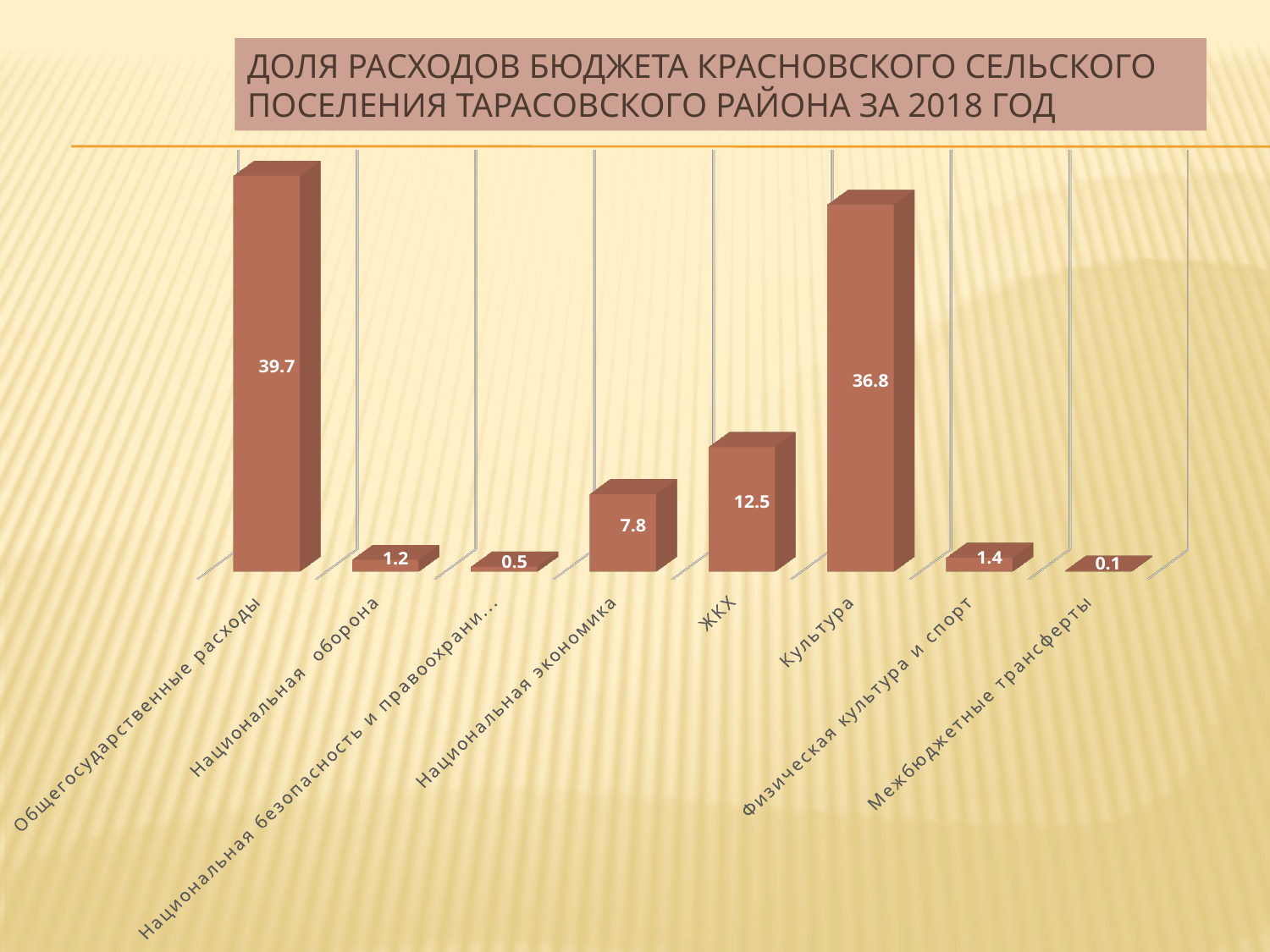
What is the difference between the values for Общегосударственные расходы and Культура? 2.9 What is the difference between the values for Физическая культура и спорт and Национальная оборона? 0.2 How many categories are shown in the chart? 8 Which category has the lowest value? Межбюджетные трансферты What is the value for Культура? 36.8 What is the value for Национальная экономика? 7.8 Which category has the highest value? Общегосударственные расходы Which is larger, the value for ЖКХ or the value for Национальная экономика? ЖКХ What kind of chart is shown on the slide? Bar chart What is the value for Общегосударственные расходы? 39.7 What is the value for Межбюджетные трансферты? 0.1 What is the value for ЖКХ? 12.5